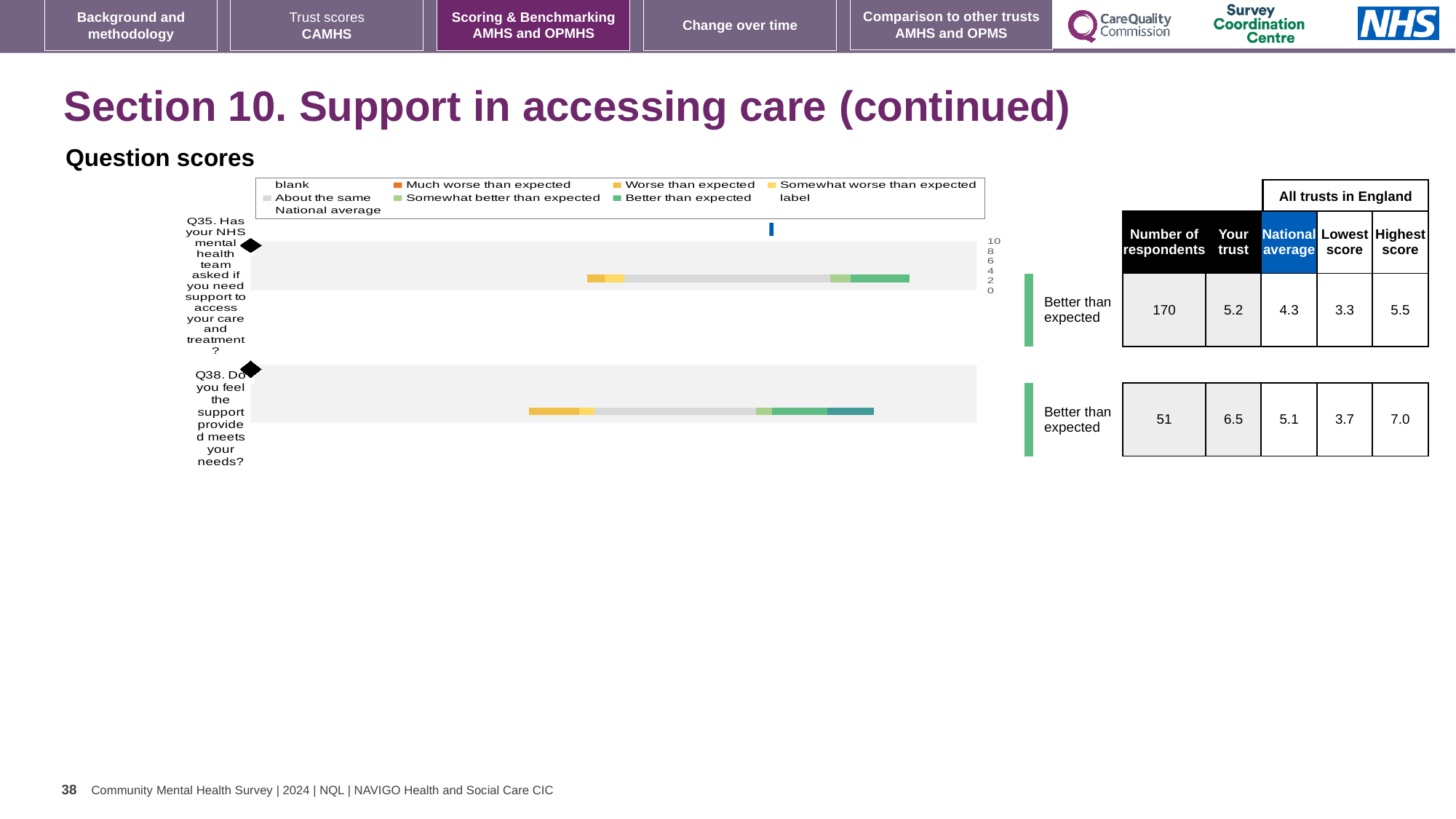
What is the difference between the 'Your trust' score and the national average for Q38? 1.4 What is the heading above the chart on this slide? Question scores What kind of chart is shown under 'Question scores'? bar chart What is the highest score among all trusts in England for Q38? 7.0 What is the national average score for Q35? 4.3 How many entries does the legend of the 'Question scores' chart list? 9 How many questions (categories) are plotted in the 'Question scores' chart? 2 How many respondents answered Q38? 51 How is the trust's result for Q35 categorised relative to expectations? Better than expected What is the 'Your trust' score for Q35 (Has your NHS mental health team asked if you need support to access your care and treatment?)? 5.2 What is the 'Your trust' score for Q38 (Do you feel the support provided meets your needs?)? 6.5 Which question has the higher 'Your trust' score, Q35 or Q38? Q38